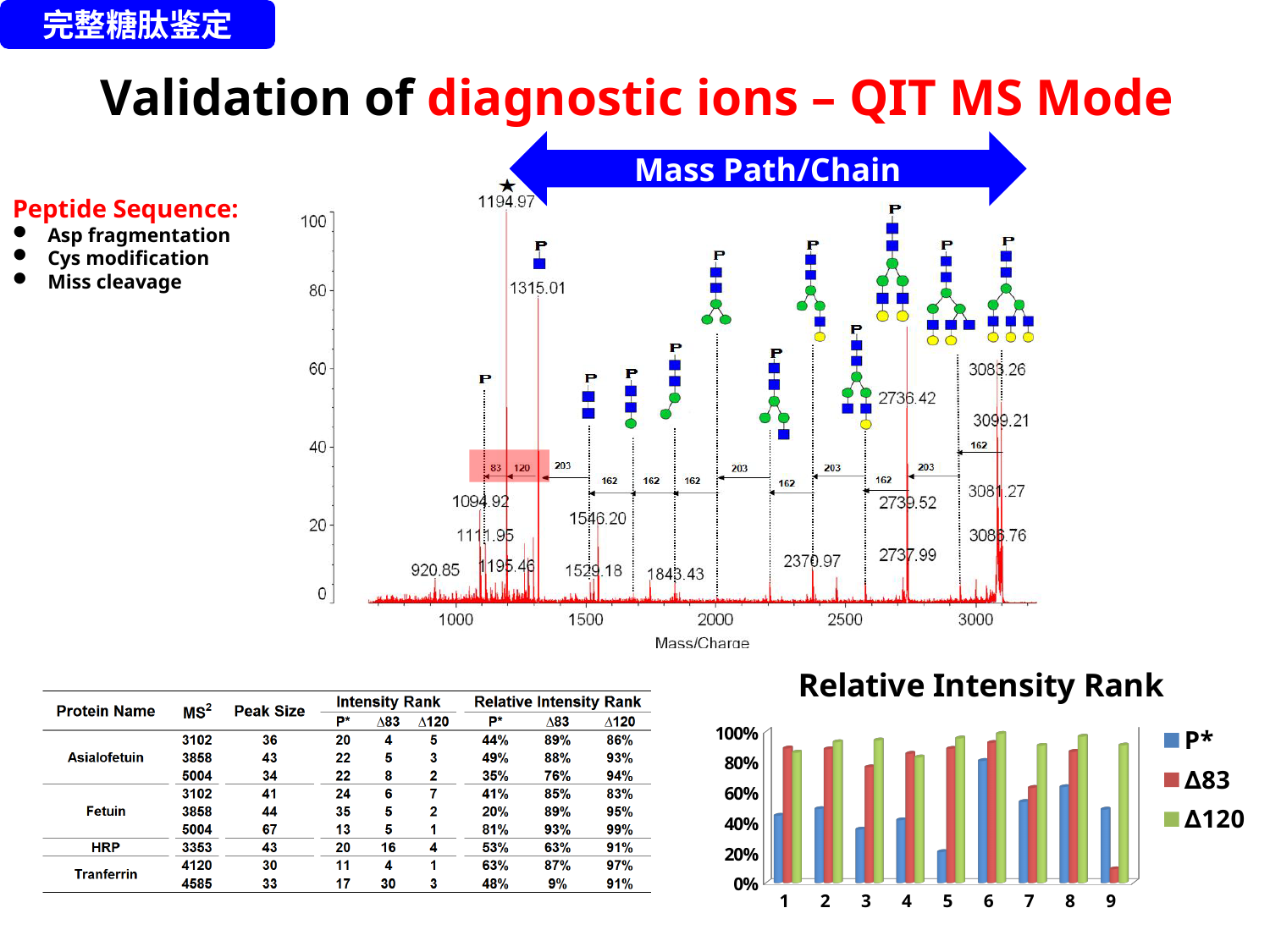
In the 'Relative Intensity Rank' chart, is the Δ83 value for category 9 greater or less than 20%? less What kind of chart is the 'Relative Intensity Rank' chart? bar chart In the 'Relative Intensity Rank' chart, is the Δ120 value for category 1 greater or less than 60%? greater In the 'Relative Intensity Rank' chart, how many series does the legend list? 3 In the 'Relative Intensity Rank' chart, for category 1, which is larger: P* or Δ83? Δ83 In the 'Relative Intensity Rank' chart, is the P* value for category 6 greater or less than 60%? greater In the 'Relative Intensity Rank' chart, how many categories are shown on the x axis? 9 In the mass spectrum chart, what is the label of the x axis? Mass/Charge In the 'Relative Intensity Rank' chart, which category has the highest P* value? 6 In the 'Relative Intensity Rank' chart, which category has the lowest Δ83 value? 9 In the 'Relative Intensity Rank' chart, for category 9, which is larger: P* or Δ83? P*